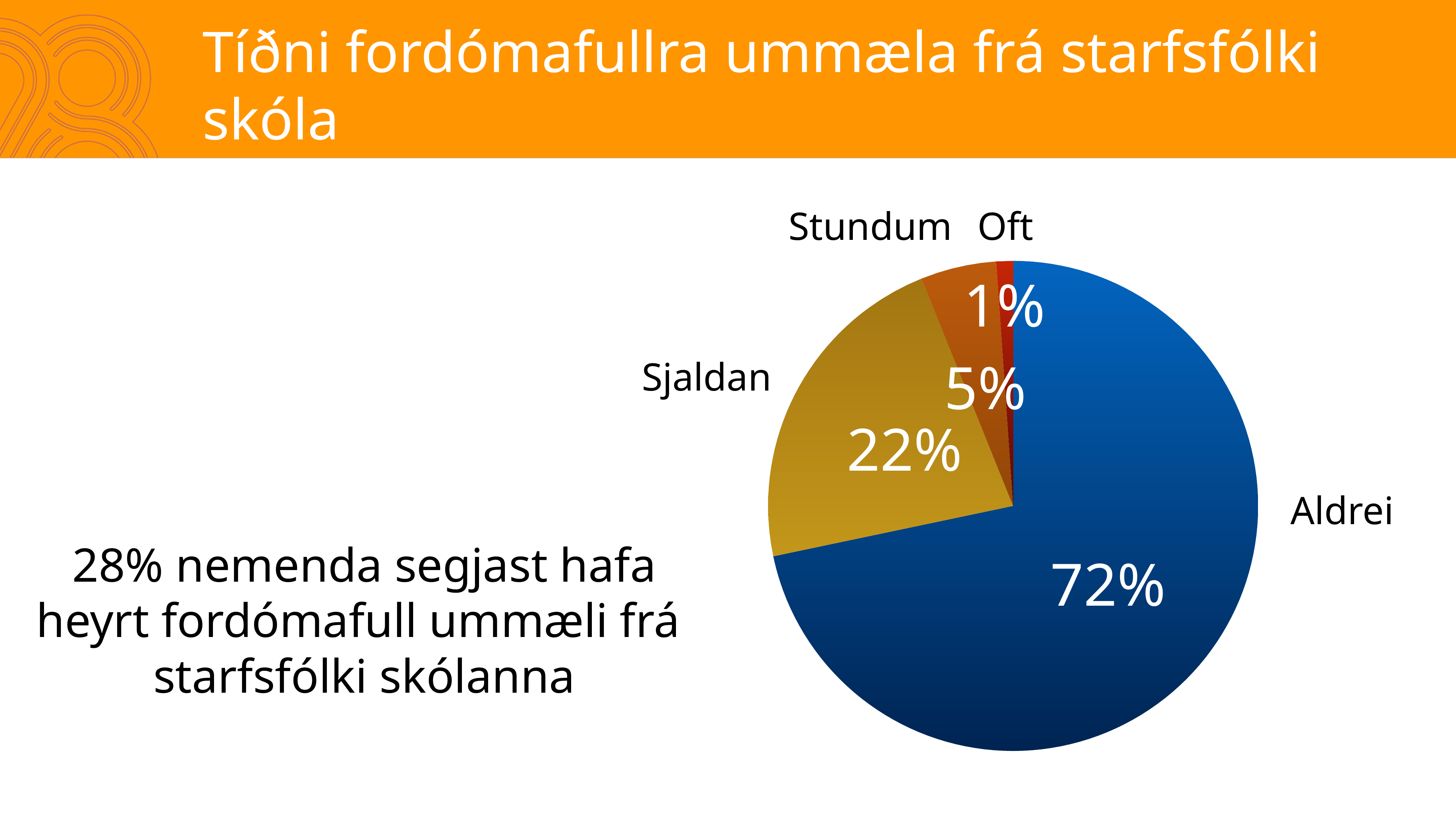
What colour is the Aldrei slice? blue What type of chart is shown on the slide? pie chart What percentage is shown for the Oft slice? 1% Which slice of the pie chart is the smallest? Oft Which slice of the pie chart is the largest? Aldrei What percentage is shown for the Aldrei slice? 72% What is the combined percentage of the Sjaldan, Stundum and Oft slices? 28% What is the difference between the Aldrei and Sjaldan percentages? 50% What percentage is shown for the Stundum slice? 5% Which is larger, the Stundum slice or the Oft slice? Stundum How many slices does the pie chart have? 4 What percentage is shown for the Sjaldan slice? 22%